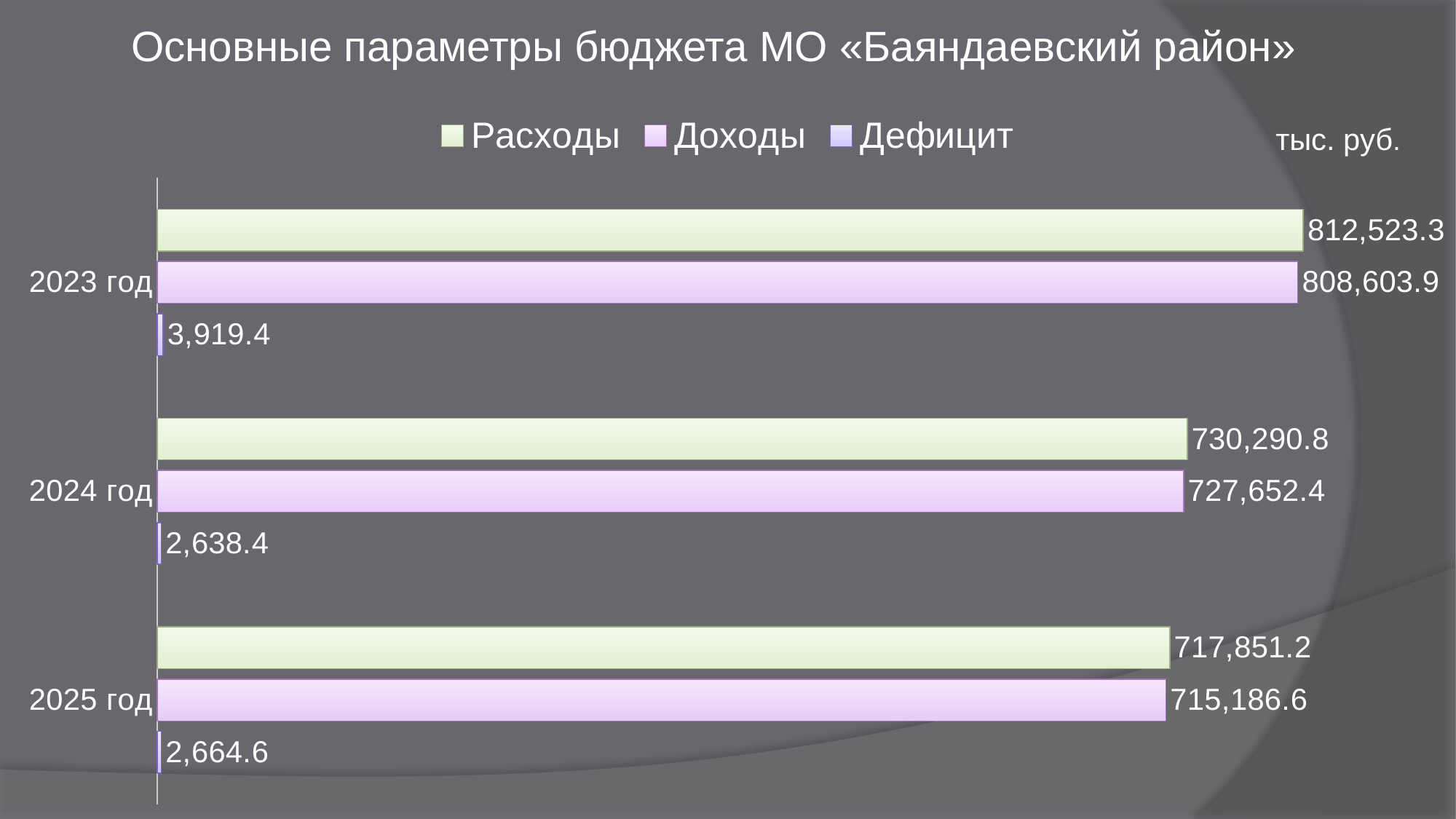
What kind of chart is shown on the slide? Bar chart What is the difference between Расходы and Доходы for 2024 год? 2,638.4 Do the values of Расходы rise or fall from 2023 год to 2025 год? Fall What is the value of Расходы for 2023 год? 812,523.3 How many series does the legend list? 3 Which year has the lowest value of Доходы? 2025 год Which year has the highest value of Расходы? 2023 год How many years (categories) are shown on the chart? 3 What is the value of Дефицит for 2025 год? 2,664.6 Which is larger: Дефицит for 2023 год or Дефицит for 2025 год? Дефицит for 2023 год What is the value of Доходы for 2024 год? 727,652.4 What is the difference between Расходы for 2023 год and Расходы for 2024 год? 82,232.5